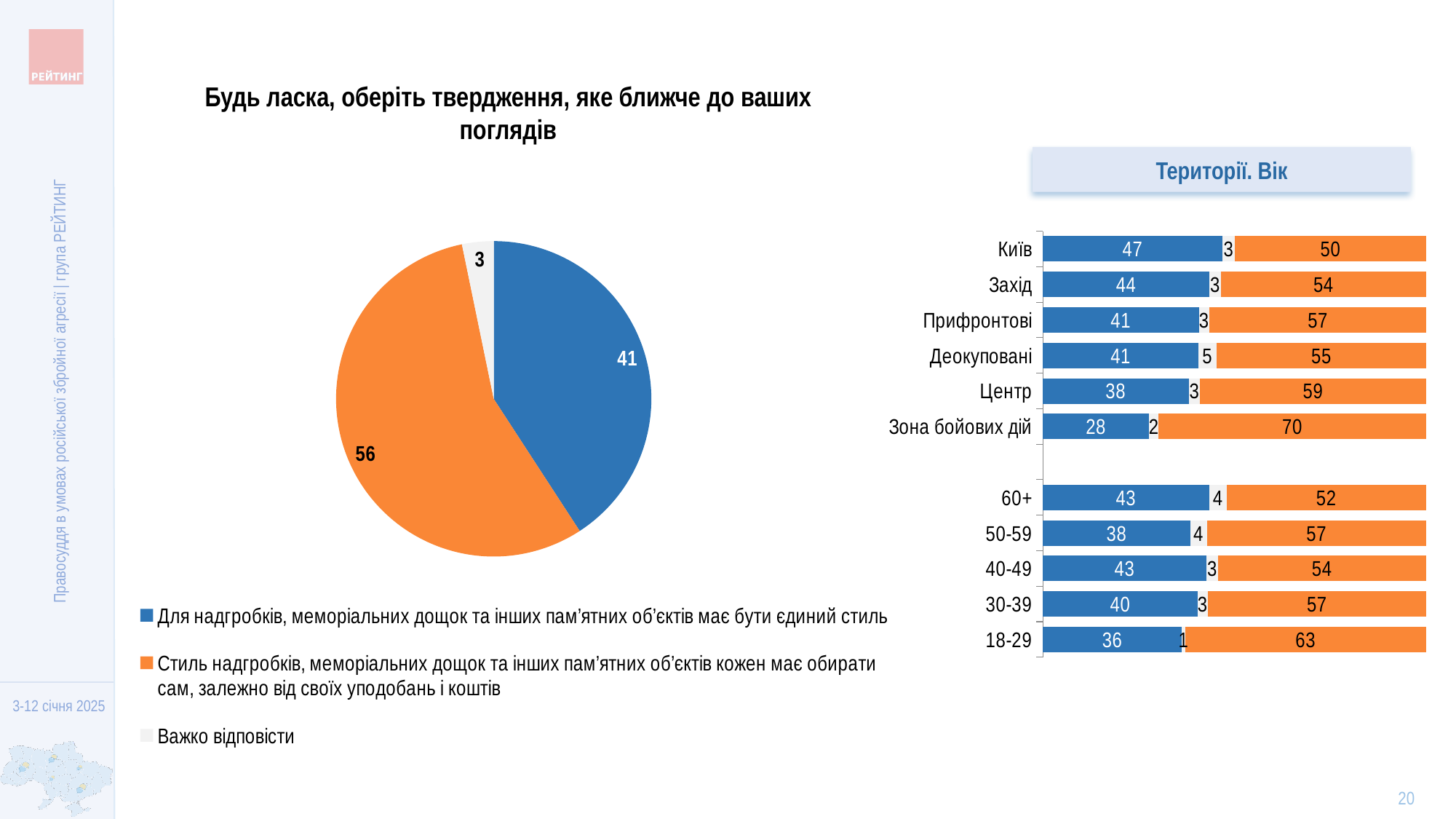
In the 'Території. Вік' chart, what is the difference between the orange values for '18-29' and '60+'? 11 What kind of chart is the 'Території. Вік' chart on the right? Bar chart In the 'Території. Вік' chart, which category has the lowest blue value? Зона бойових дій In the 'Території. Вік' chart, what is the orange value for 'Зона бойових дій'? 70 In the 'Території. Вік' chart, which is larger: the blue value for 'Захід' or the blue value for 'Центр'? Захід In the pie chart on the left, what value is shown for the orange slice (everyone should choose the style themselves)? 56 In the pie chart on the left, what share of respondents chose the statement that tombstones and memorial objects should have a single style (blue slice)? 41 In the 'Території. Вік' chart, which category has the highest orange value? Зона бойових дій In the pie chart on the left, what value is shown for 'Важко відповісти'? 3 What kind of chart is the chart on the left of the slide? Pie chart In the 'Території. Вік' chart, what is the blue value for 'Київ'? 47 How many categories are shown in the 'Території. Вік' chart? 11